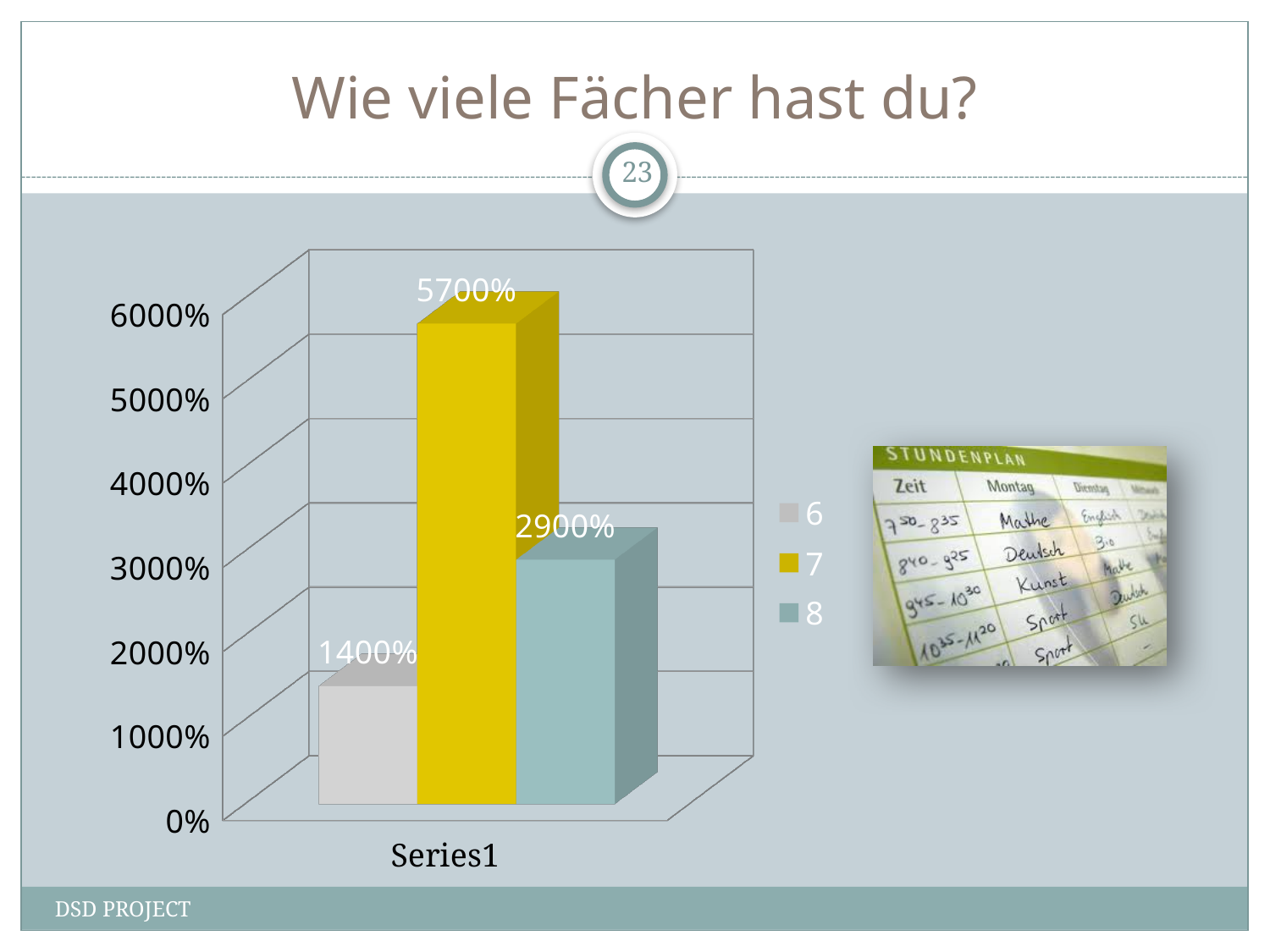
What kind of chart is shown on the slide? bar chart Which legend entry has the lowest value? 6 Is the value for 7 greater or less than 5000%? greater What value is shown for the legend entry 8? 2900% Which legend entry has the highest value? 7 What is the difference between the values for 8 and 6? 1500% What is the difference between the values for 7 and 8? 2800% What value is shown for the legend entry 7? 5700% What value is shown for the legend entry 6? 1400% What is the title of the slide containing the chart? Wie viele Fächer hast du? Which is larger, the value for 6 or the value for 8? 8 How many bars are plotted in the chart? 3